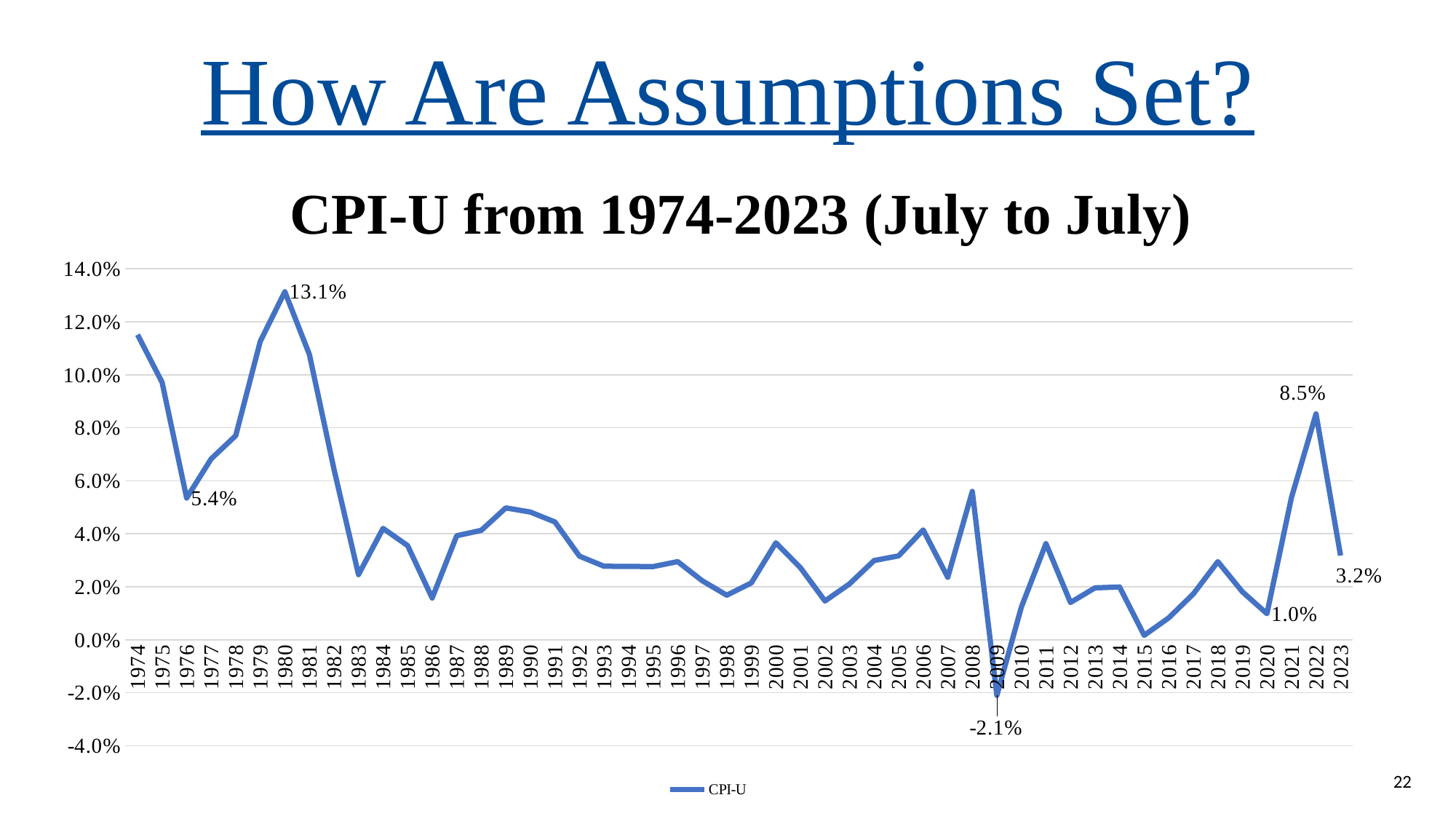
What is the title of the chart? CPI-U from 1974-2023 (July to July) What is the CPI-U value for 2009? -2.1% What is the CPI-U value for 1980? 13.1% Which is larger, the CPI-U value for 1980 or for 2022? 1980 Is the CPI-U value for 1974 greater or less than 10.0%? greater What kind of chart is shown on the slide? line chart What is the difference between the CPI-U values for 2022 and 2023? 5.3% How many series does the legend list? 1 What is the CPI-U value for 2023? 3.2% Which year has the highest CPI-U value? 1980 What is the CPI-U value for 2022? 8.5% Which year has the lowest CPI-U value? 2009